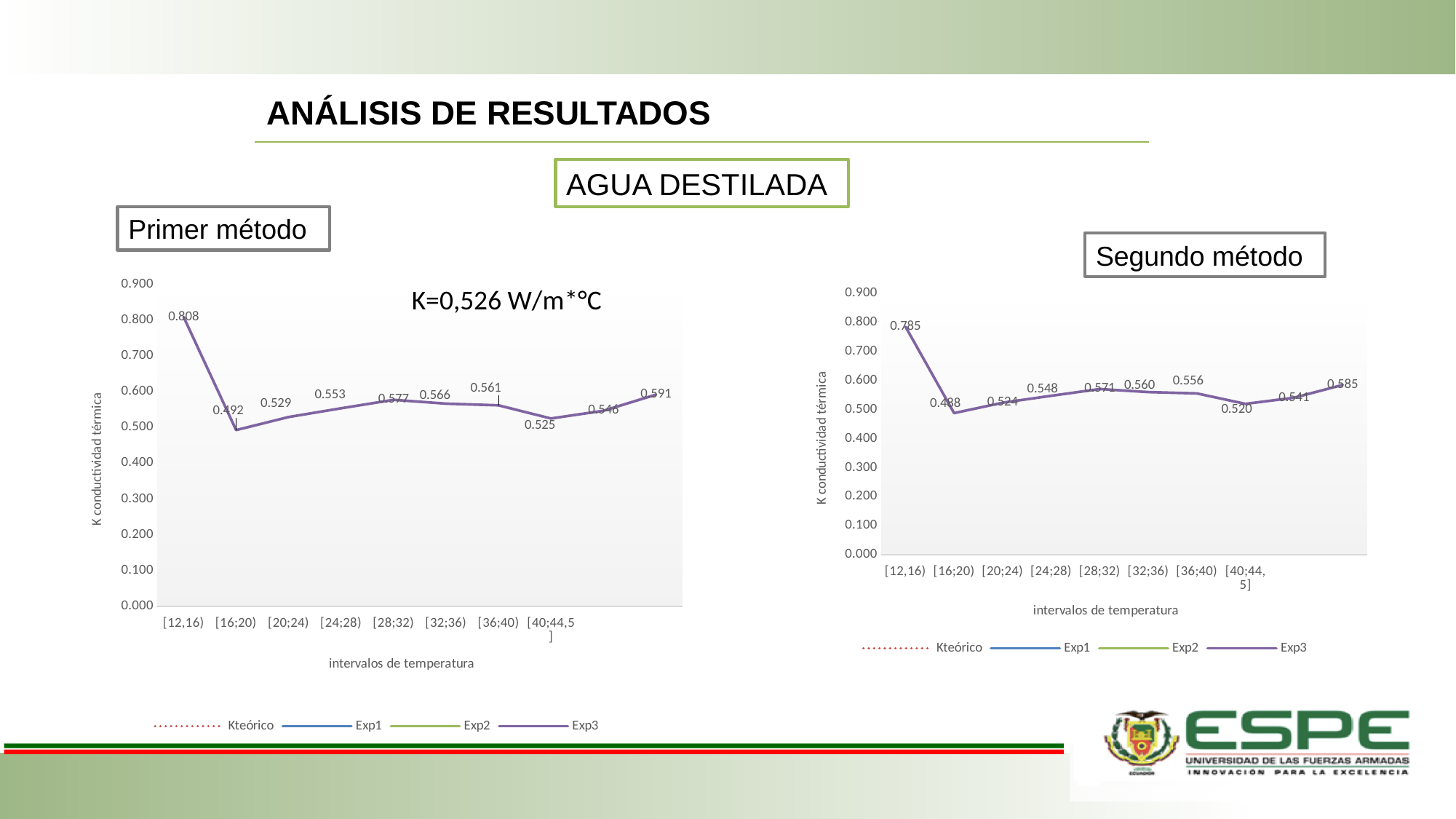
How many series does the legend of the Primer método chart list? 4 In the Primer método chart, what is the lowest labelled value on the line? 0.492 In the Primer método chart, what is the highest labelled value on the line? 0.808 What theoretical K value is printed on the Primer método chart? K=0,526 W/m*°C In the Primer método chart, what is the difference between the first point (0.808) and the second point (0.492)? 0.316 What type of chart is the Segundo método chart? Line chart In the Segundo método chart, what is the lowest labelled value on the line? 0.488 In the Segundo método chart, what is the value of the first data point, at the [12,16] interval? 0.785 Which is larger: the first data point of the Primer método chart or the first data point of the Segundo método chart? Primer método (0.808) In the Segundo método chart, is the first data point greater or less than 0.700? greater In the Primer método chart, what is the value of the first data point, at the [12,16] interval? 0.808 In the Segundo método chart, what is the difference between the highest labelled value (0.785) and the lowest labelled value (0.488)? 0.297